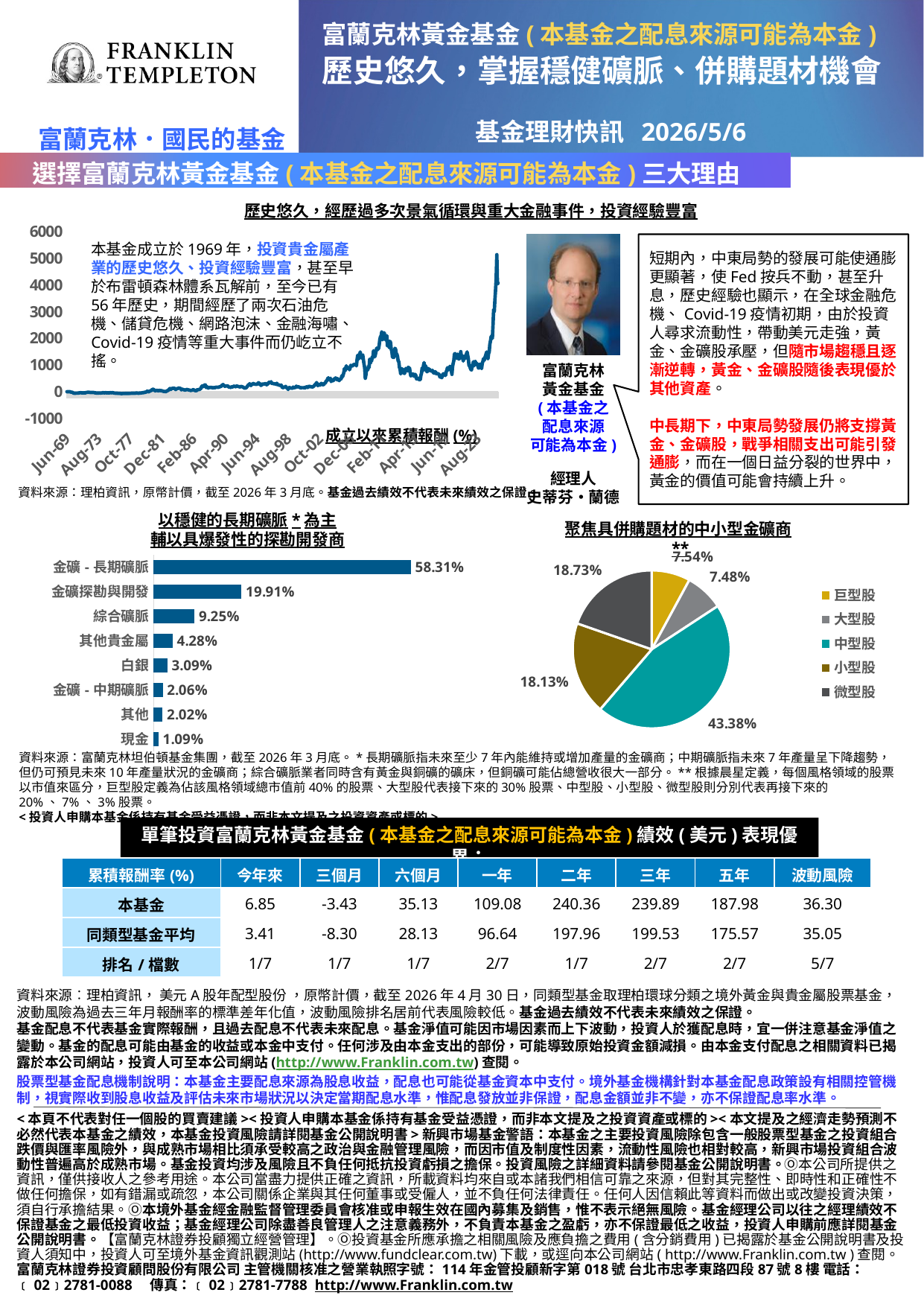
What kind of chart is the chart titled 成立以來累積報酬 (%) at the top of the slide? Line chart In the pie chart titled 聚焦具併購題材的中小型金礦商**, how many entries does the legend list? 5 In the pie chart titled 聚焦具併購題材的中小型金礦商**, which category has the largest slice? 中型股 In the line chart titled 成立以來累積報酬 (%), is the value at the right end of the line greater or less than 4000? greater In the bar chart titled 以穩健的長期礦脈*為主 輔以具爆發性的探勘開發商, what is the value for 金礦 - 長期礦脈? 58.31% In the bar chart titled 以穩健的長期礦脈*為主 輔以具爆發性的探勘開發商, which is larger, 綜合礦脈 or 其他貴金屬? 綜合礦脈 In the bar chart titled 以穩健的長期礦脈*為主 輔以具爆發性的探勘開發商, how many categories are shown? 8 In the pie chart titled 聚焦具併購題材的中小型金礦商**, what colour is the 中型股 slice? Teal In the pie chart titled 聚焦具併購題材的中小型金礦商**, what share does 中型股 have? 43.38% In the bar chart titled 以穩健的長期礦脈*為主 輔以具爆發性的探勘開發商, what is the value for 白銀? 3.09% In the bar chart titled 以穩健的長期礦脈*為主 輔以具爆發性的探勘開發商, what is the difference between 金礦 - 長期礦脈 and 金礦探勘與開發? 38.40% In the bar chart titled 以穩健的長期礦脈*為主 輔以具爆發性的探勘開發商, which category has the lowest value? 現金